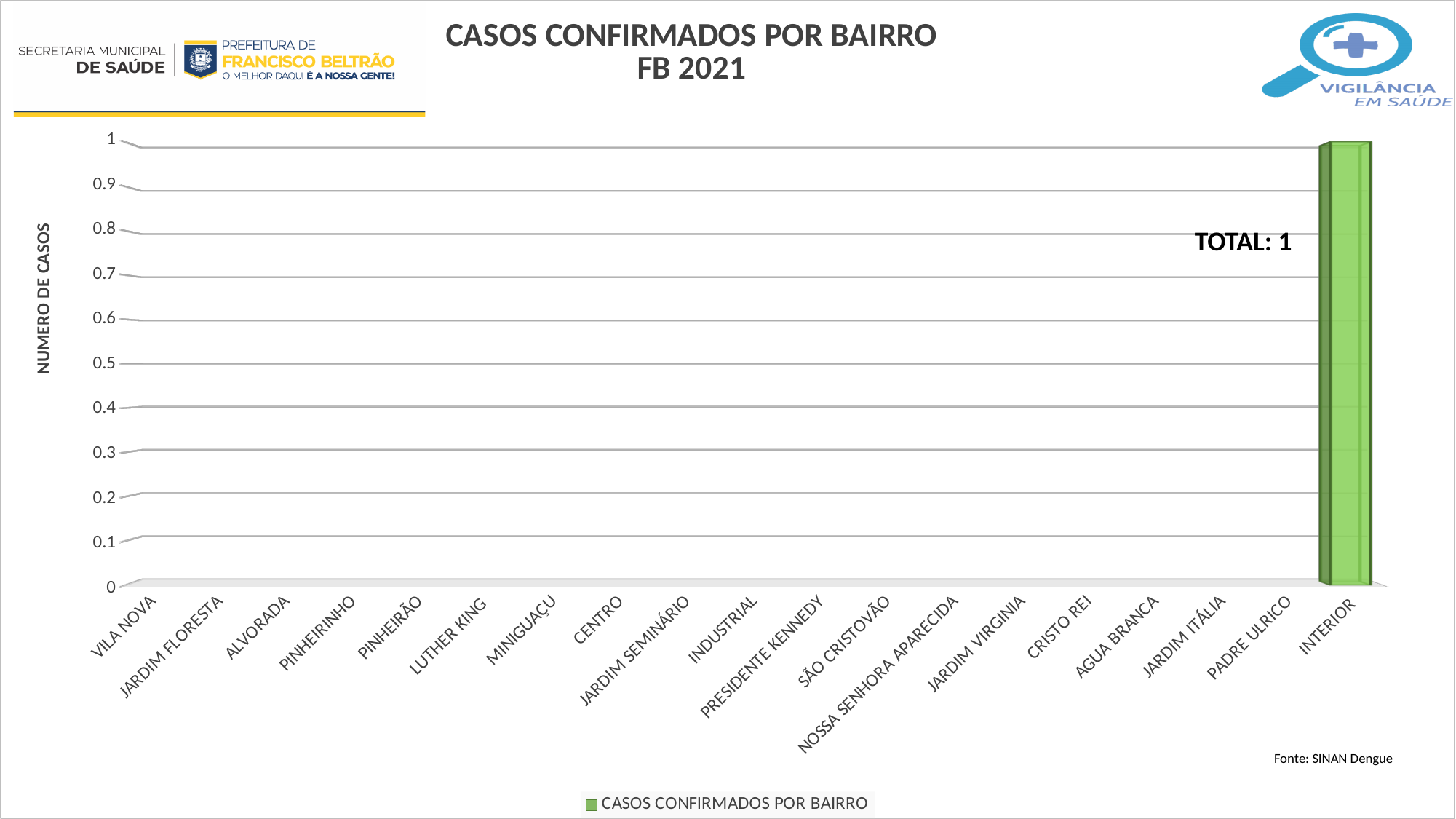
What kind of chart is shown on the slide? bar chart Is the value for INTERIOR greater or less than 0.5? greater What is the label of the y axis? NUMERO DE CASOS Which bairro has the highest number of confirmed cases? INTERIOR What is the number of confirmed cases for INTERIOR? 1 How many series does the legend list? 1 How many bairros (categories) are listed on the x axis? 19 What is the total number of confirmed cases shown on the chart? 1 What is the title of the chart? CASOS CONFIRMADOS POR BAIRRO FB 2021 Which has more confirmed cases, INTERIOR or CENTRO? INTERIOR